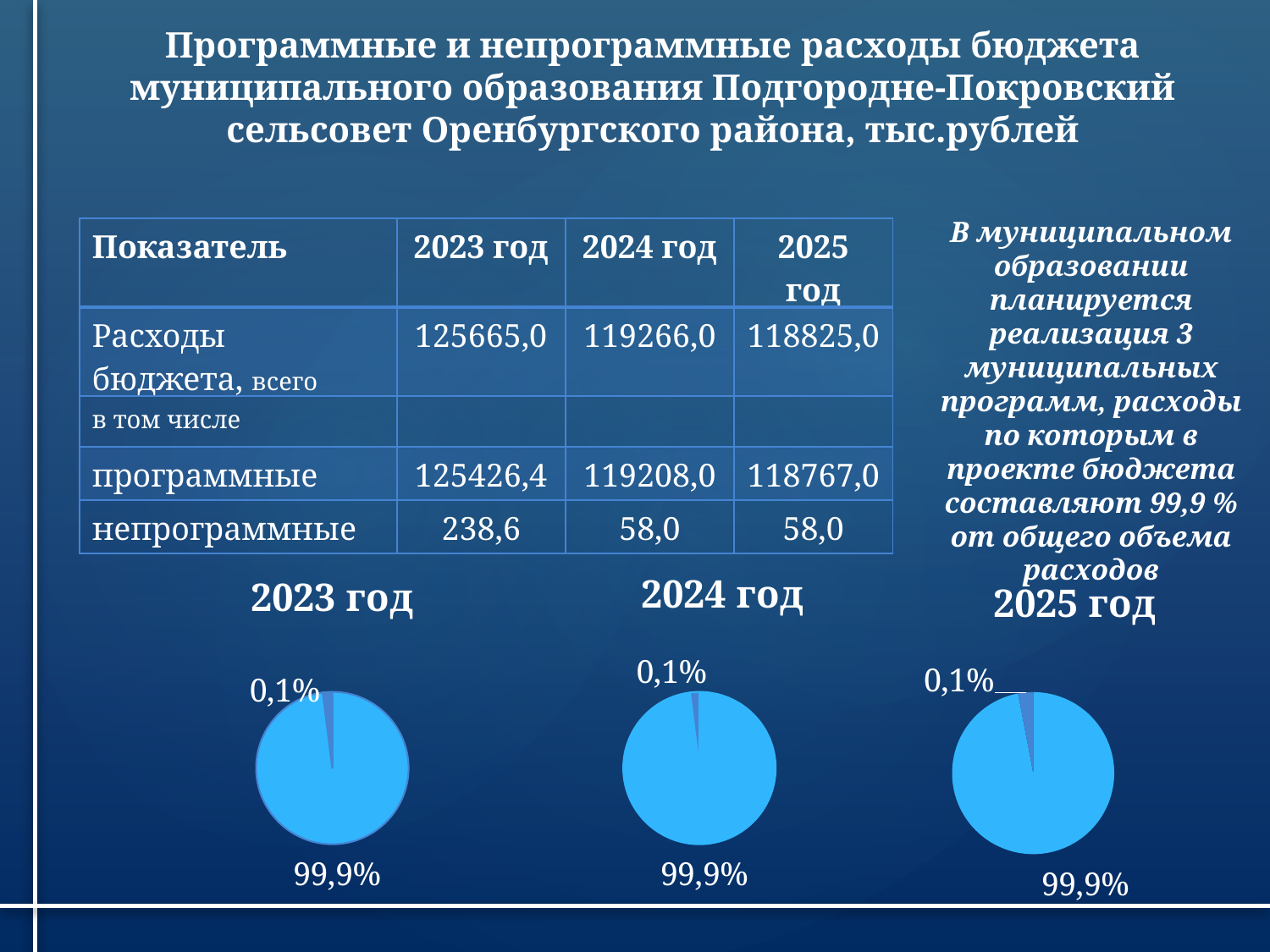
In the "2024 год" pie chart, which slice is larger, the one labelled 99,9% or the one labelled 0,1%? 99,9% How many slices does the "2024 год" pie chart have? 2 In the "2025 год" pie chart, what share does the smallest slice have? 0,1% In the "2023 год" pie chart, what is the difference between the two slice shares? 99,8% In the "2023 год" pie chart, what share does the largest slice have? 99,9% Does the share of the largest slice change between the "2023 год" and "2025 год" pie charts? No, it stays at 99,9% What is the title of the pie chart on the far right of the slide? 2025 год How many pie charts are shown on the slide? 3 What kind of chart is the "2023 год" chart? pie chart In the "2024 год" pie chart, what share does the largest slice have? 99,9%